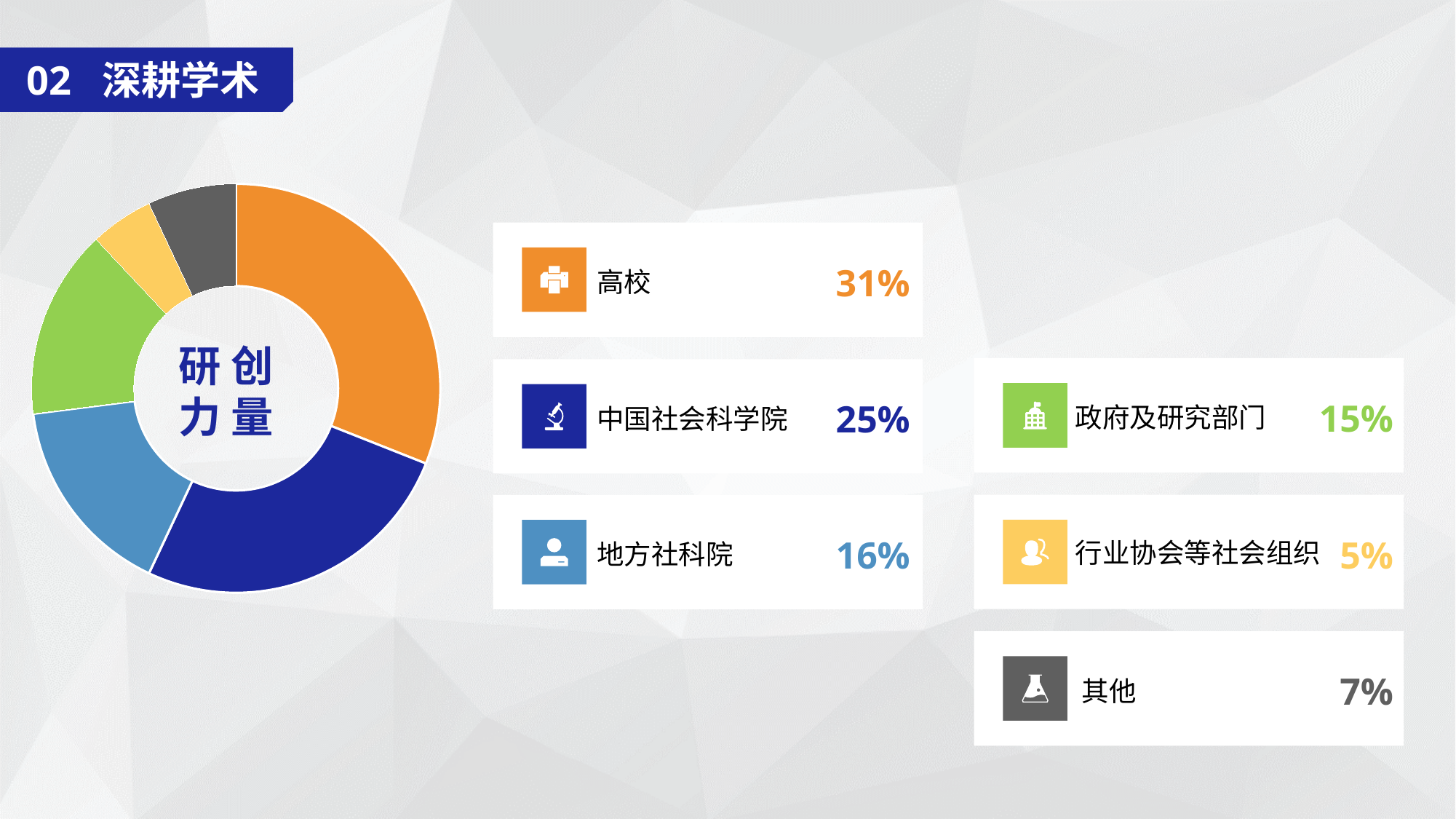
What percentage is shown for 中国社会科学院? 25% What text appears in the centre of the donut chart? 研创力量 Which category has the smallest share of the donut chart? 行业协会等社会组织 What percentage is shown for 地方社科院? 16% Which category has the largest share of the donut chart? 高校 What percentage is shown for 行业协会等社会组织? 5% What percentage is shown for 政府及研究部门? 15% What kind of chart is shown on the slide? Donut (pie) chart Which is larger, the share for 其他 or the share for 行业协会等社会组织? 其他 What share of the donut chart does 高校 account for? 31% How many categories are shown in the donut chart? 6 What is the difference in percentage points between 高校 and 中国社会科学院? 6